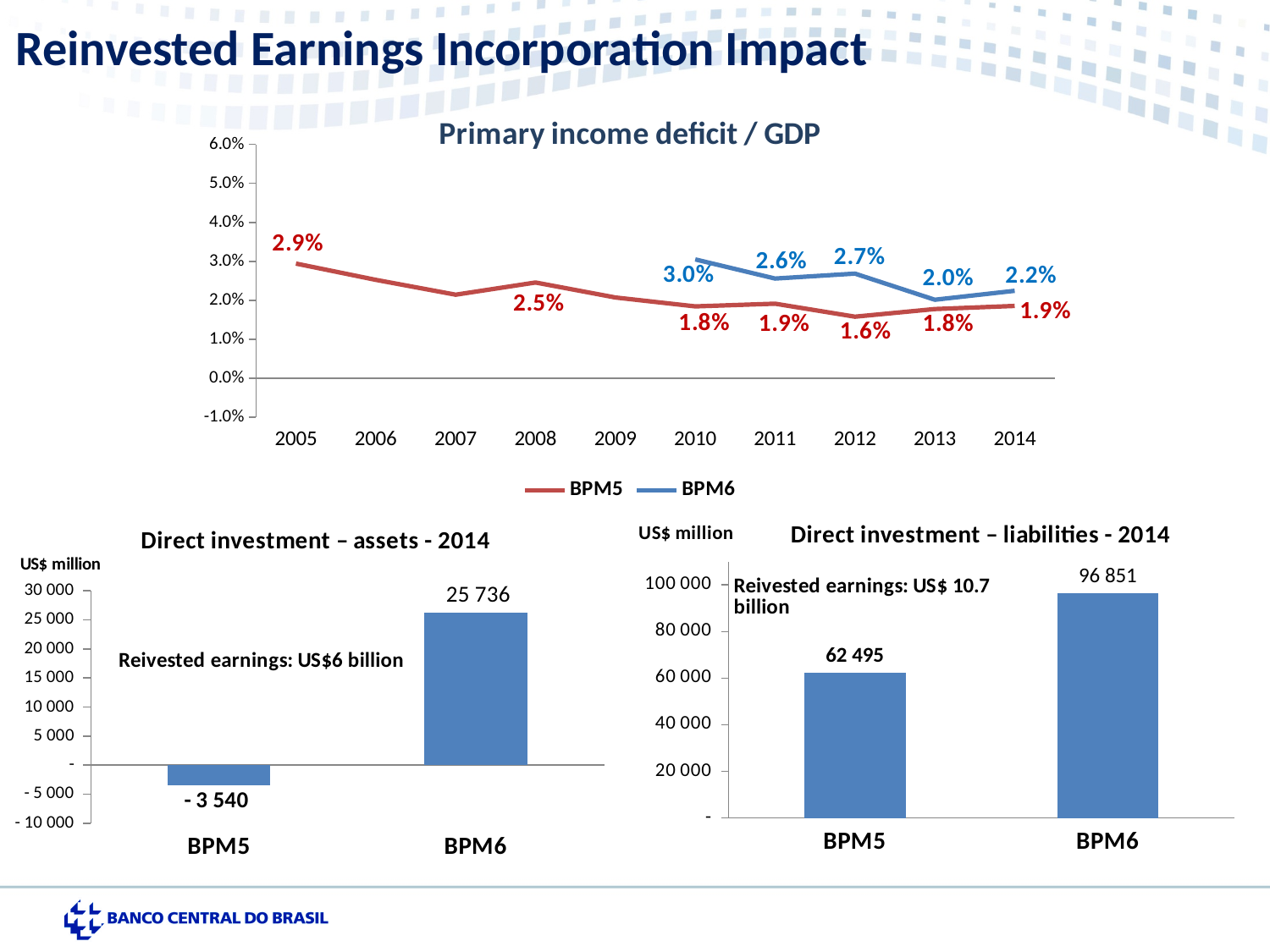
In the 'Primary income deficit / GDP' chart, in which year does the BPM6 series reach its highest value? 2010 How many years are shown on the x axis of the 'Primary income deficit / GDP' chart? 10 In the 'Primary income deficit / GDP' chart, in which year does the BPM5 series reach its lowest value? 2012 In the 'Primary income deficit / GDP' chart, what is the BPM6 value for 2012? 2.7% In the 'Primary income deficit / GDP' chart, is the BPM5 value for 2007 greater or less than 3.0%? less In the 'Direct investment – liabilities - 2014' chart, what is the difference between the BPM6 and BPM5 values? 34 356 How many series does the legend of the 'Primary income deficit / GDP' chart list? 2 What kind of chart is 'Direct investment – liabilities - 2014'? bar chart In the 'Primary income deficit / GDP' chart, what is the BPM5 value for 2005? 2.9% In the 'Direct investment – assets - 2014' chart, which category has the larger value, BPM5 or BPM6? BPM6 In the 'Direct investment – liabilities - 2014' chart, what is the value for BPM5? 62 495 In the 'Direct investment – assets - 2014' chart, what is the value for BPM6? 25 736